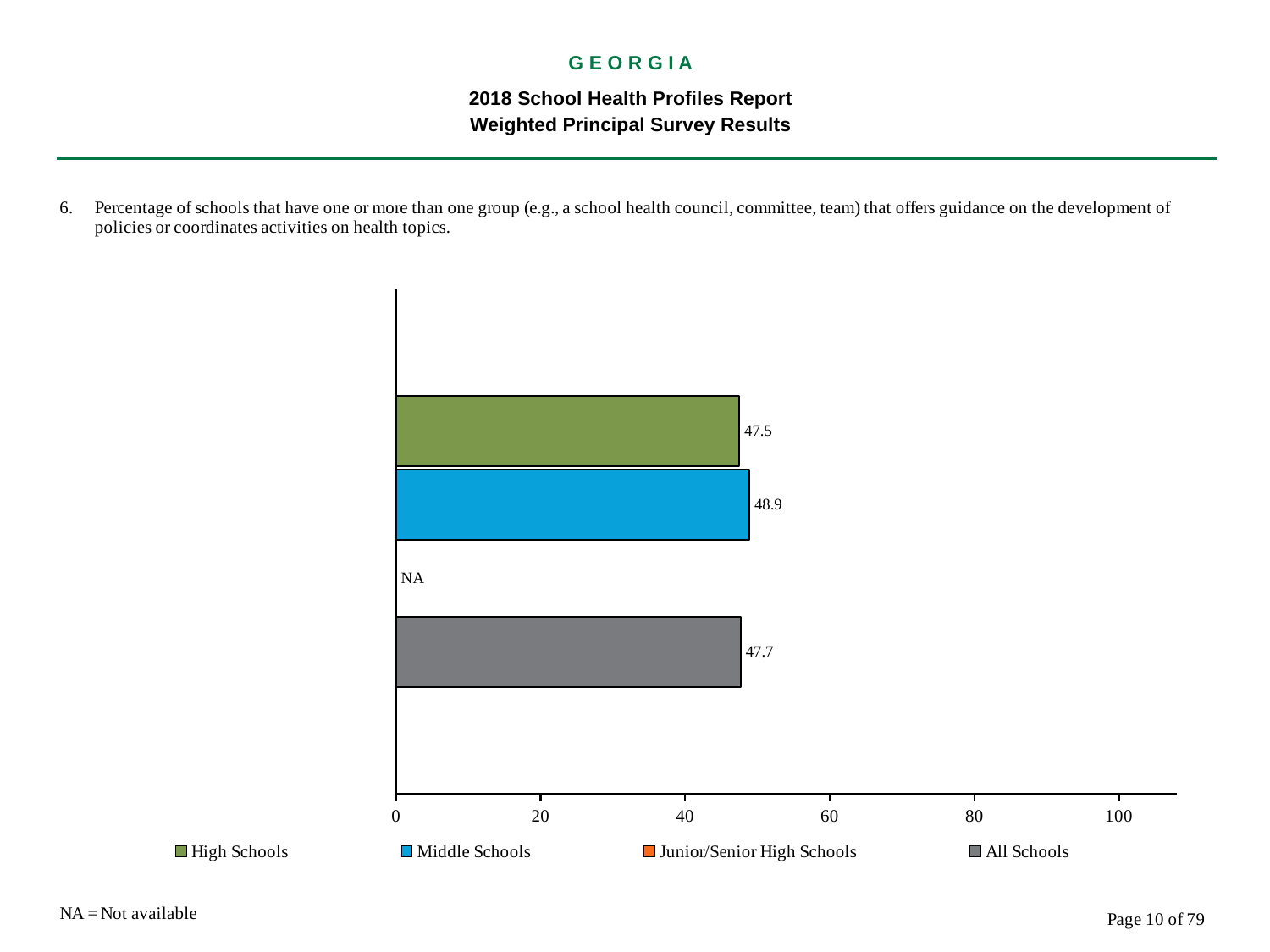
Which school type with a plotted value has the lowest value? High Schools What is the value for Middle Schools? 48.9 What is shown for Junior/Senior High Schools? NA What colour is the bar for Middle Schools? blue What is the value for High Schools? 47.5 What is the value for All Schools? 47.7 What is the difference between the values for Middle Schools and All Schools? 1.2 Which school type has the highest value? Middle Schools How many series does the legend list? 4 What kind of chart is shown on the slide? bar chart What is the difference between the values for Middle Schools and High Schools? 1.4 Is the value for Middle Schools greater or less than 40? greater